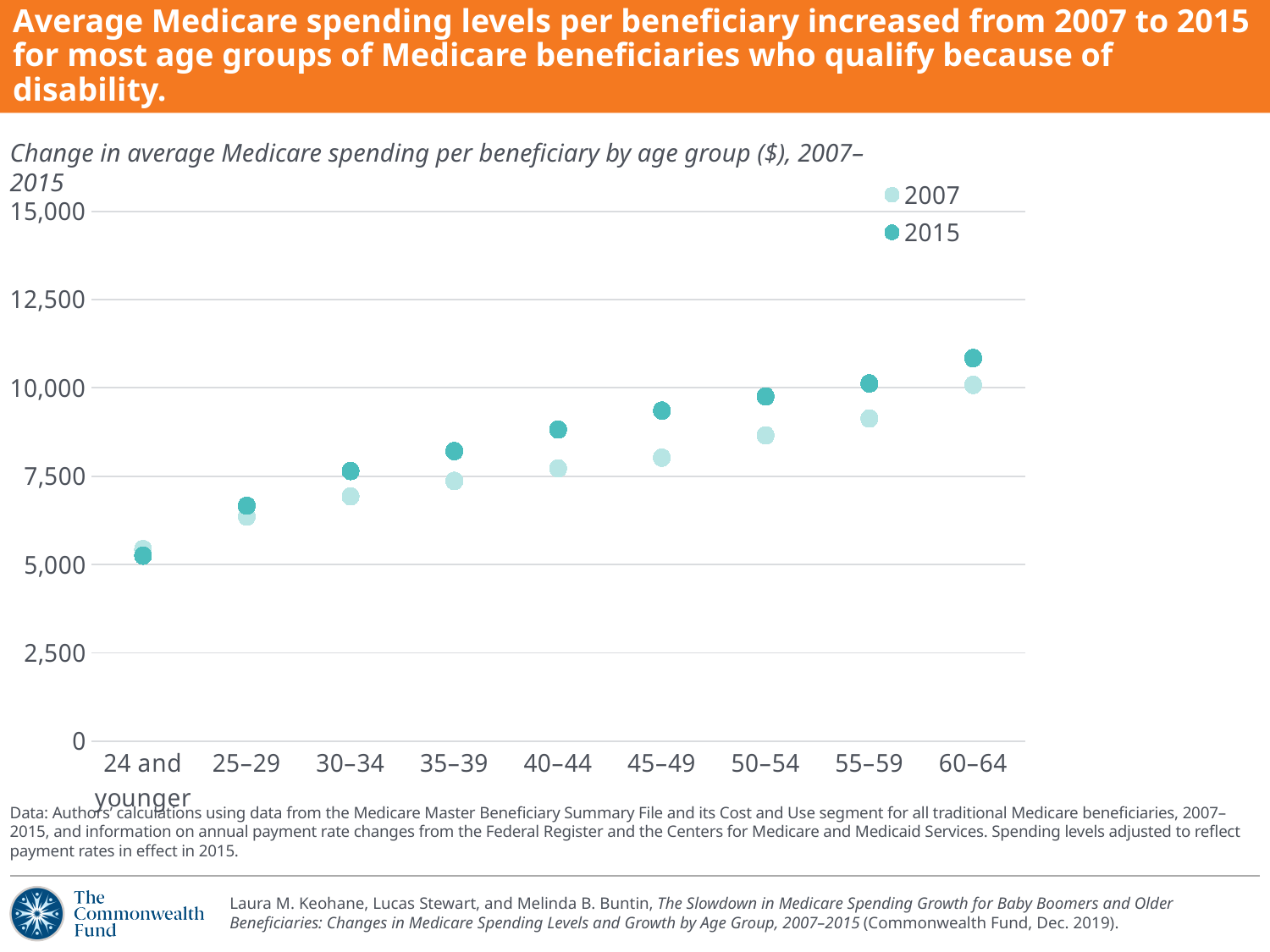
Which age group has the lowest 2015 value? 24 and younger Is the 2007 value for the 30–34 age group greater or less than 7,500? less How many series does the legend list? 2 Which age group has the highest 2015 value? 60–64 For the 24 and younger age group, which is larger: the 2007 value or the 2015 value? 2007 How many age groups are plotted along the x axis? 9 Do the 2015 values rise or fall as age group increases along the x axis? Rise Is the 2015 value for the 60–64 age group greater or less than 10,000? greater What are the two entries in the chart legend? 2007 and 2015 Is the 2015 value for the 40–44 age group greater or less than 7,500? greater For the 45–49 age group, which is larger: the 2007 value or the 2015 value? 2015 What kind of chart is shown on the slide? Scatter (dot) chart